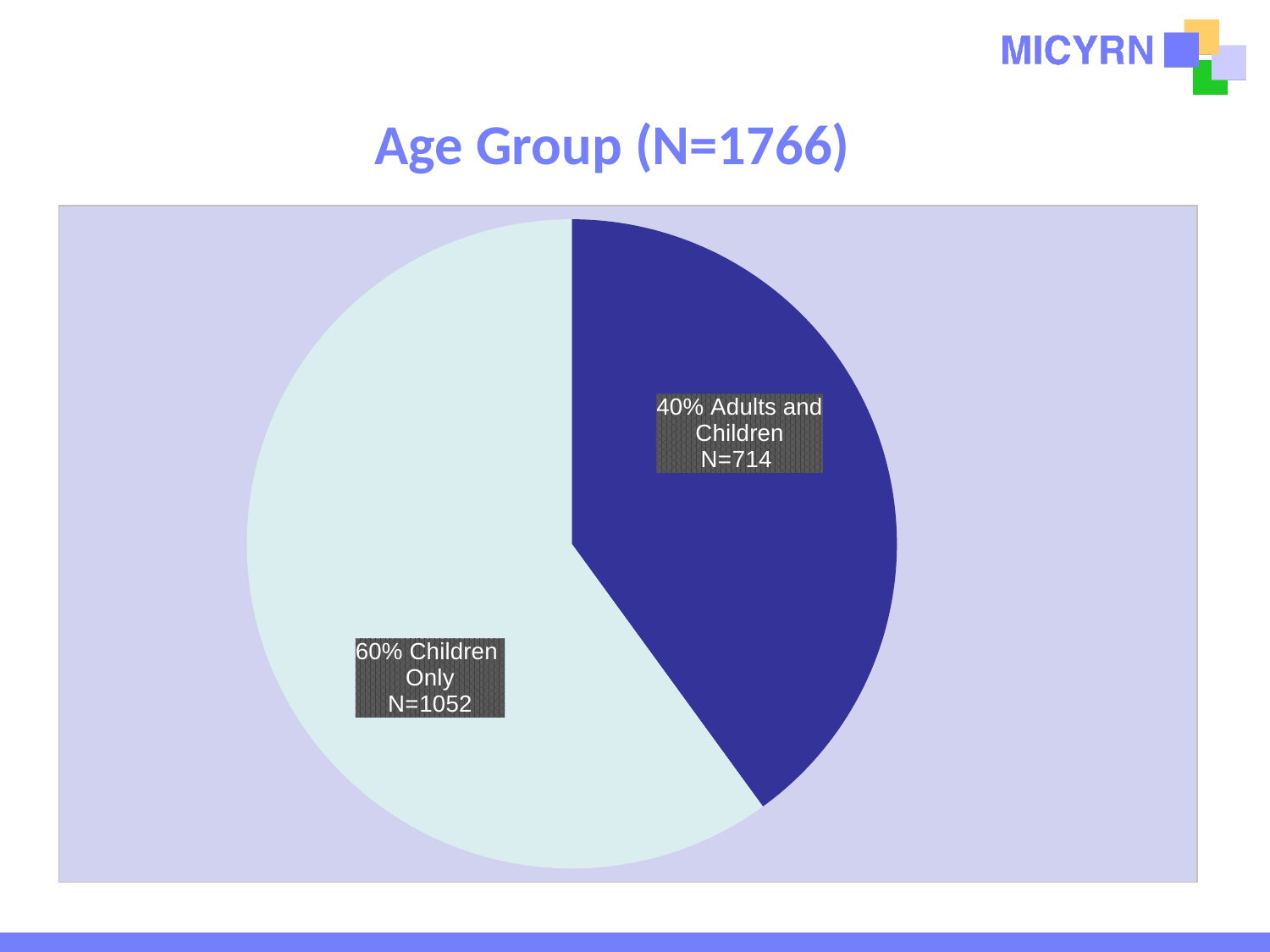
What is the difference in N between Children Only and Adults and Children? 338 What colour is the Adults and Children slice? dark blue Which is larger, Children Only or Adults and Children? Children Only What share of the pie is Children Only? 60% What is the N value for the Adults and Children slice? N=714 What is the title of the chart? Age Group (N=1766) How many slices does the pie chart have? 2 What is the N value for the Children Only slice? N=1052 What kind of chart is shown on the slide? pie chart What share of the pie is Adults and Children? 40% Which slice is the smallest? Adults and Children Which slice is the largest? Children Only